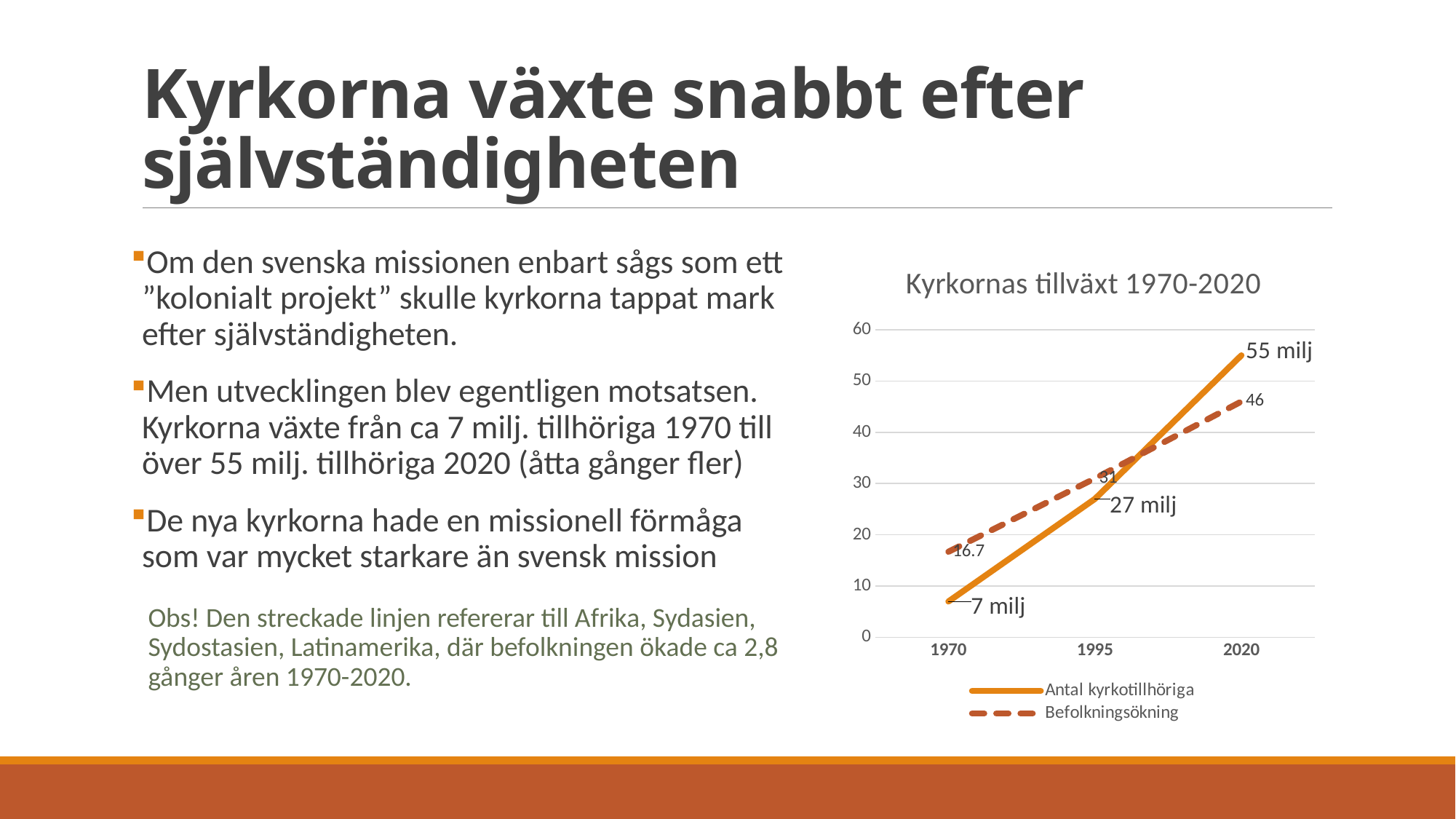
What kind of chart is shown on the slide? line chart What is the title of the chart? Kyrkornas tillväxt 1970-2020 What is the difference between Antal kyrkotillhöriga in 2020 and in 1970? 48 milj How many series does the chart legend list? 2 Which series has the larger value in 2020, Antal kyrkotillhöriga or Befolkningsökning? Antal kyrkotillhöriga Does Befolkningsökning rise or fall from 1970 to 2020? rise What is the value of Befolkningsökning in 1970? 16.7 How many years are shown on the x axis of the chart? 3 What is the value of Befolkningsökning in 1995? 31 What is the value of Antal kyrkotillhöriga in 1970? 7 milj In which year is Antal kyrkotillhöriga highest? 2020 What is the value of Antal kyrkotillhöriga in 2020? 55 milj